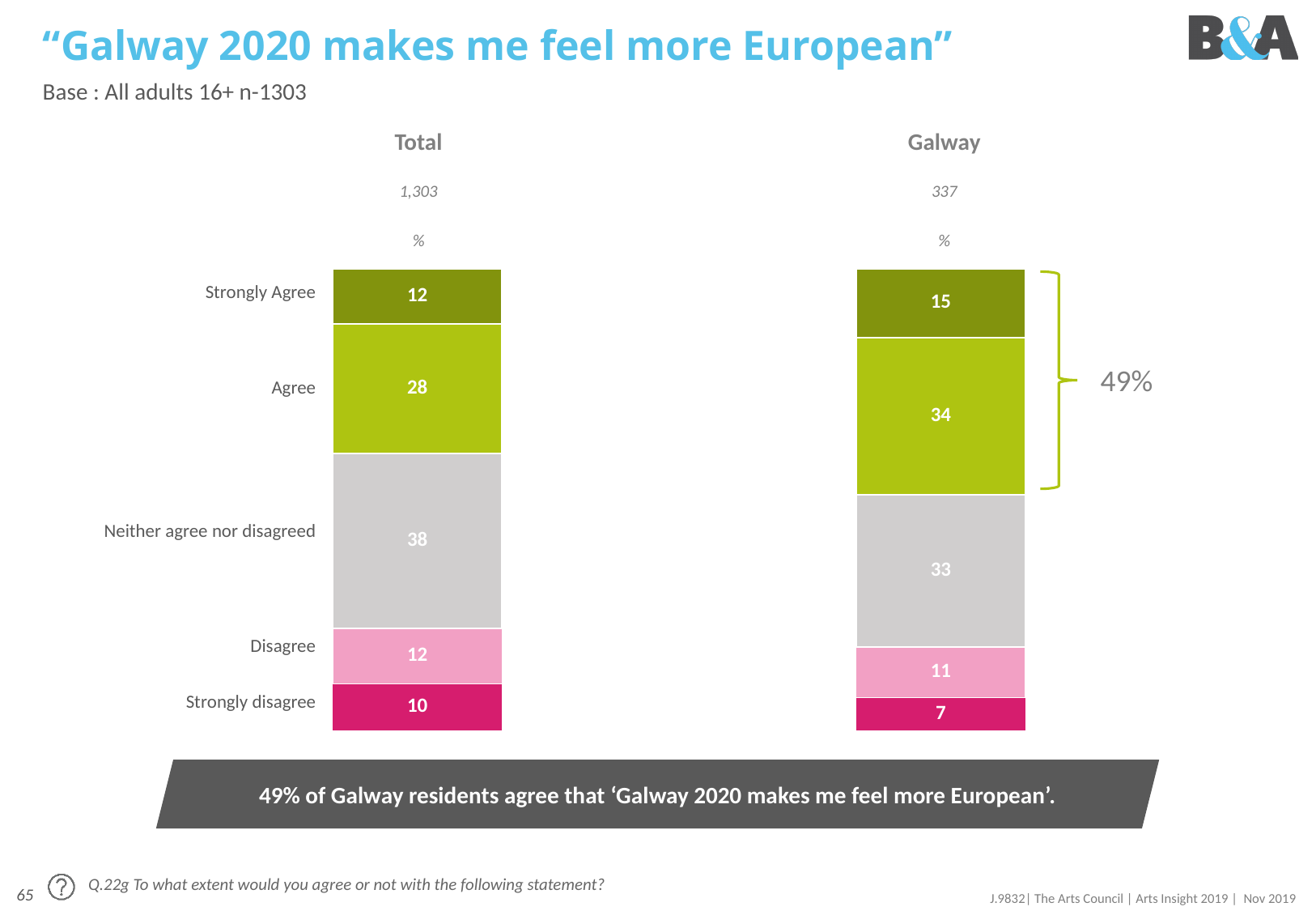
How many response categories are shown in each stacked bar? 5 What is the sample size (n) shown for the Galway column? 337 Which response category has the smallest share in the Galway column? Strongly disagree What kind of chart is shown on the slide? Stacked bar chart What percentage of the Galway column 'Agree' with the statement? 34 What is the combined 'Strongly Agree' plus 'Agree' share for Galway, as labelled on the slide? 49% What is the difference between the 'Agree' values for Galway and Total? 6 What is the combined 'Strongly Agree' plus 'Agree' share for the Total column? 40 Which is larger: 'Strongly disagree' for Total or for Galway? Total What is the 'Neither agree nor disagreed' value for Galway? 33 Which response category has the largest share in the Total column? Neither agree nor disagreed What percentage of the Total column 'Strongly Agree' with the statement? 12